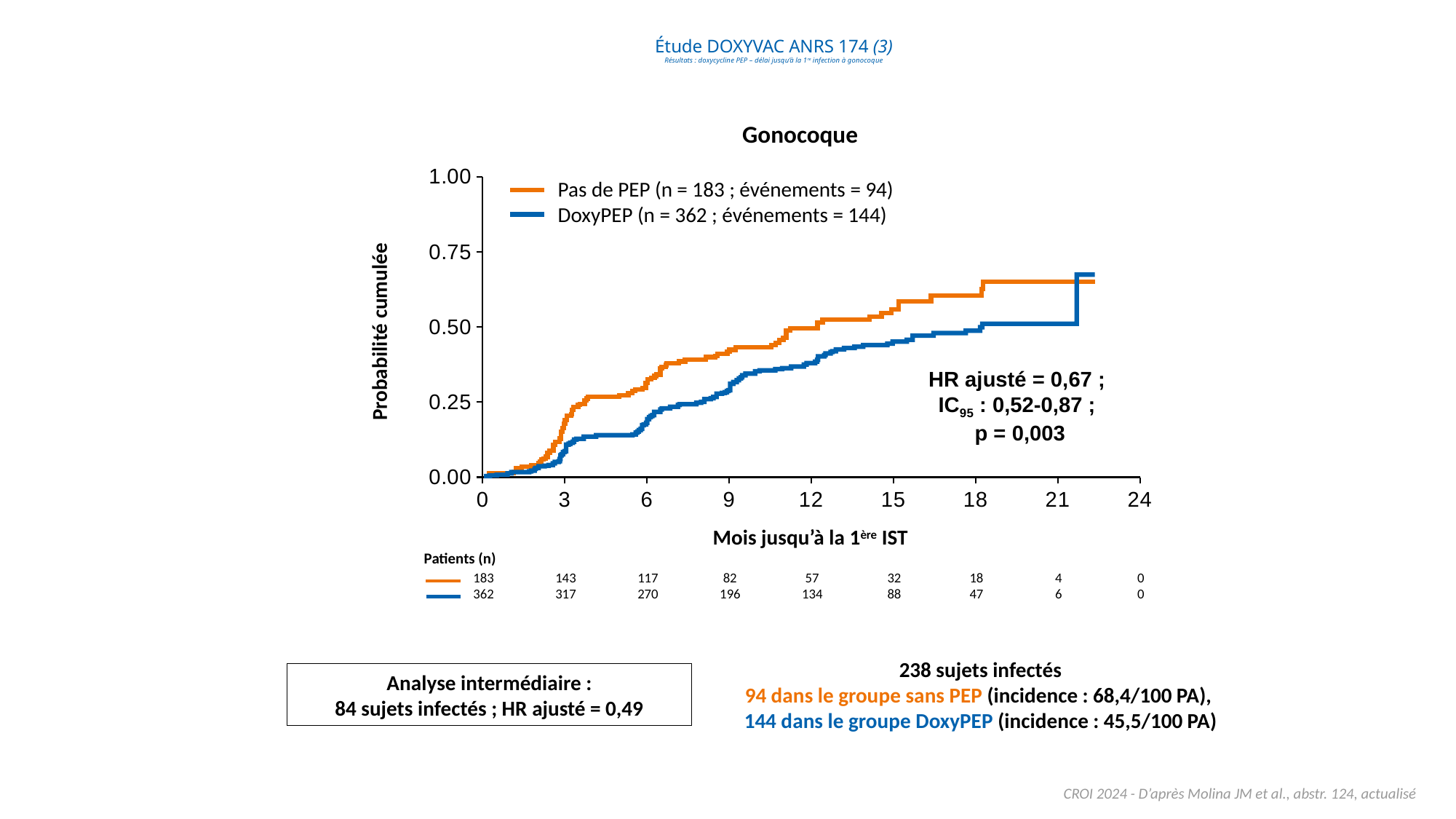
Which colour represents the DoxyPEP group in the chart? Blue According to the legend, how many events occurred in the Pas de PEP group? 94 What kind of chart is shown on the slide? Line chart In the patients-at-risk table, how many DoxyPEP patients remained at month 12? 134 Is the cumulative probability for the Pas de PEP curve at month 9 greater or less than 0.50? less According to the legend, how many participants were in the DoxyPEP group? 362 Do the cumulative probability curves rise or fall as months increase? Rise In the patients-at-risk table, how many Pas de PEP patients remained at month 6? 117 How many series does the legend of the Gonocoque chart list? 2 What is the title of the chart? Gonocoque At month 12, which curve shows the higher cumulative probability, Pas de PEP or DoxyPEP? Pas de PEP What is the difference in the number of patients at risk at month 0 between the DoxyPEP and Pas de PEP groups? 179